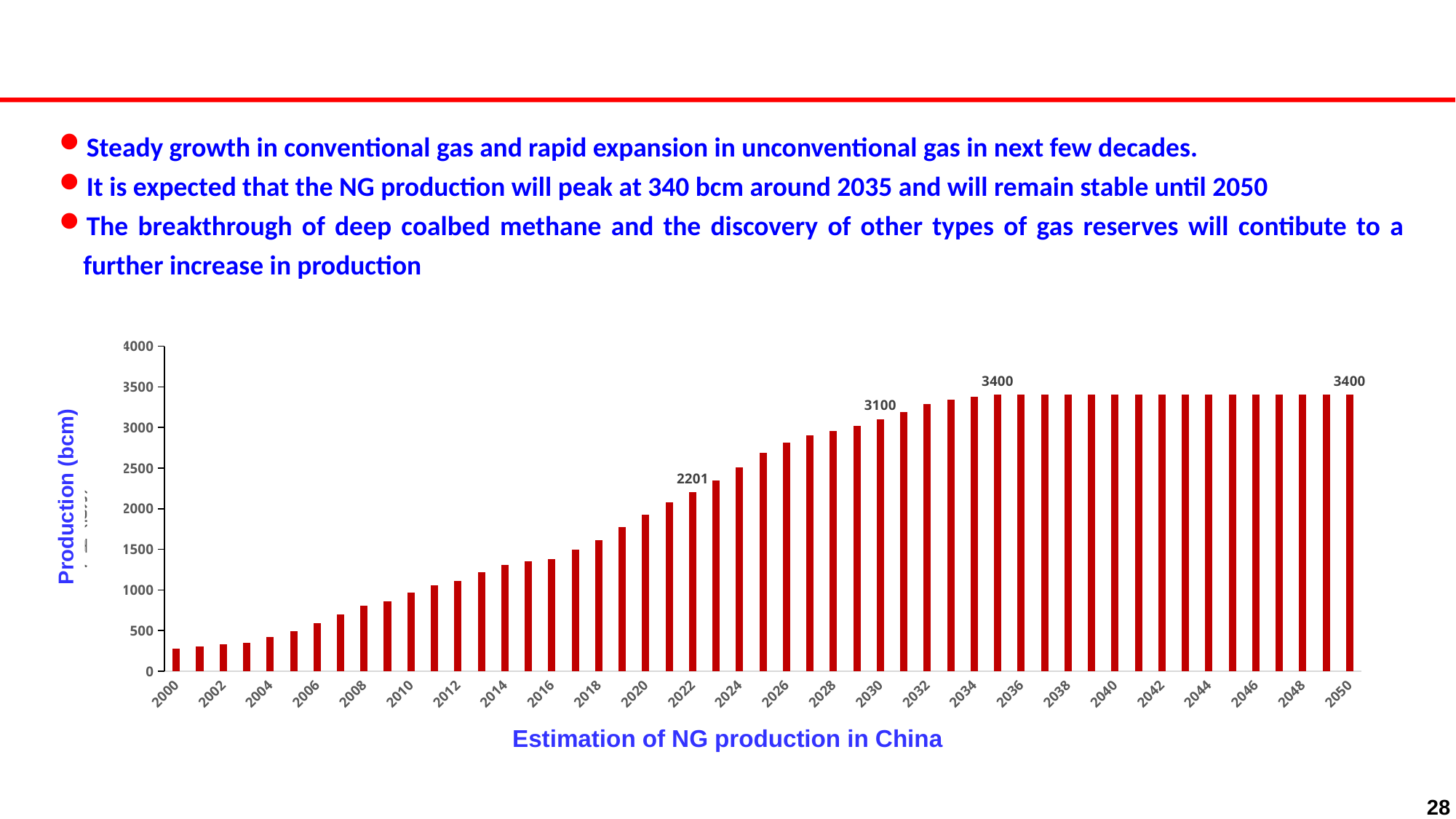
What is the difference between the values for 2030 and 2022? 899 Is the value for 2040 greater or less than 3000? greater What is the title of the chart? Estimation of NG production in China What is the value for 2035 in the chart? 3400 What is the value for 2030 in the chart? 3100 What is the value for 2022 in the chart? 2201 Which year has a larger value, 2022 or 2030? 2030 What kind of chart is shown on the slide? bar chart Is the value for 2000 greater or less than 500? less Which year has the lowest value in the chart? 2000 What is the value for 2050 in the chart? 3400 What is the difference between the values for 2035 and 2030? 300